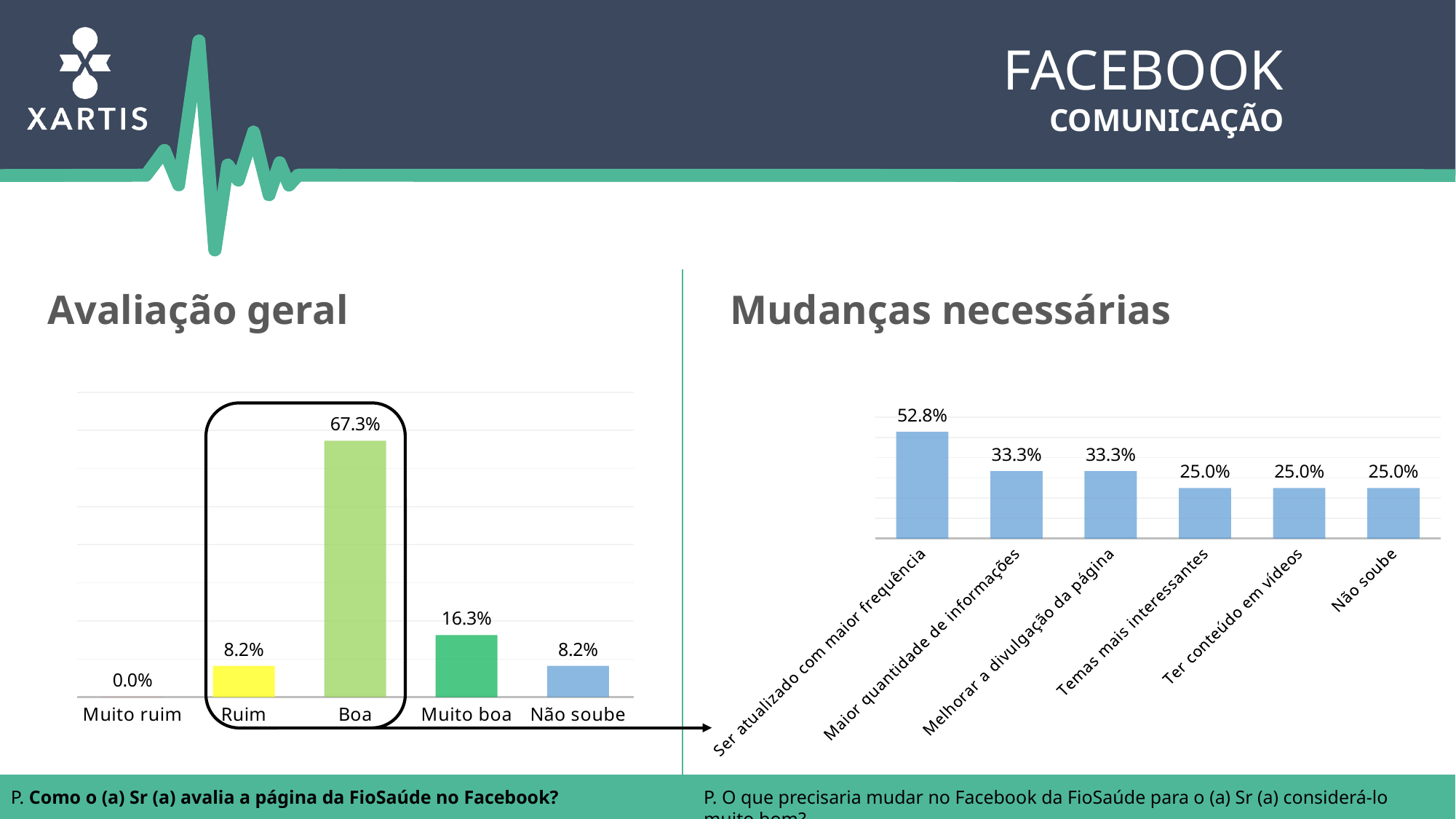
In the 'Mudanças necessárias' chart, what is the value for 'Ser atualizado com maior frequência'? 52.8% In the 'Mudanças necessárias' chart, how many categories are shown? 6 In the 'Avaliação geral' chart, which category has the highest value? Boa What kind of chart is the 'Avaliação geral' chart? Bar chart In the 'Avaliação geral' chart, which category has the lowest value? Muito ruim In the 'Mudanças necessárias' chart, what is the value for 'Ter conteúdo em vídeos'? 25.0% In the 'Avaliação geral' chart, what is the value for 'Muito boa'? 16.3% In the 'Avaliação geral' chart, what is the value for 'Boa'? 67.3% In the 'Avaliação geral' chart, how many categories are shown on the x axis? 5 In the 'Mudanças necessárias' chart, is the value for 'Maior quantidade de informações' larger or smaller than the value for 'Temas mais interessantes'? Larger In the 'Mudanças necessárias' chart, which category has the highest value? Ser atualizado com maior frequência In the 'Avaliação geral' chart, what is the difference between the values for 'Boa' and 'Muito boa'? 51.0%